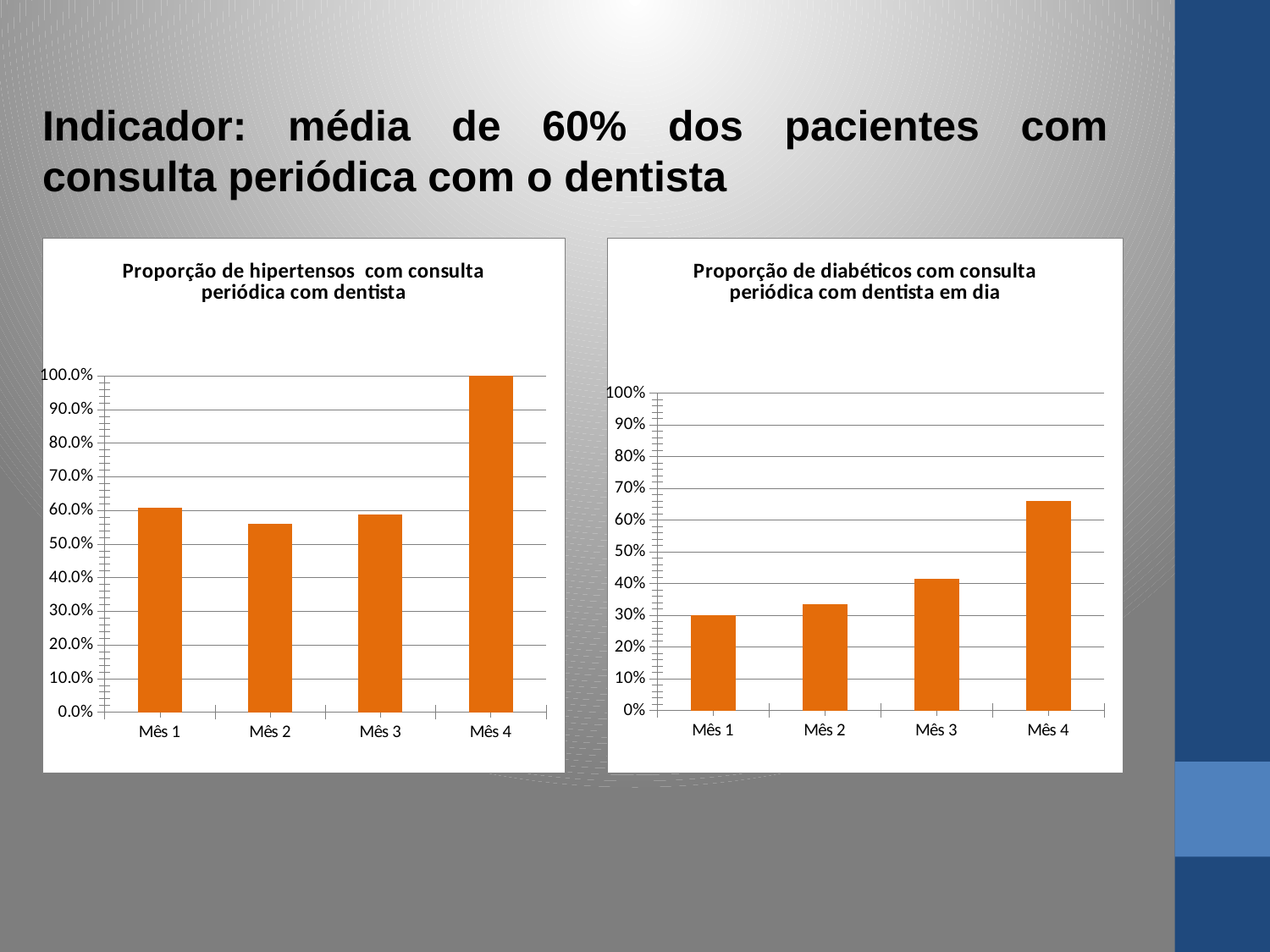
In the left chart, 'Proporção de hipertensos com consulta periódica com dentista', which month has the lowest value? Mês 2 In the right chart, 'Proporção de diabéticos com consulta periódica com dentista em dia', which is larger, the value for Mês 2 or the value for Mês 4? Mês 4 In the left chart, 'Proporção de hipertensos com consulta periódica com dentista', which month has the highest value? Mês 4 What kind of chart is the left chart, 'Proporção de hipertensos com consulta periódica com dentista'? bar chart In the right chart, 'Proporção de diabéticos com consulta periódica com dentista em dia', do the values rise or fall from Mês 1 to Mês 4? rise In the left chart, 'Proporção de hipertensos com consulta periódica com dentista', what is the value for Mês 4? 100.0% In the right chart, 'Proporção de diabéticos com consulta periódica com dentista em dia', is the value for Mês 3 greater or less than 50%? less What is the title of the right chart? Proporção de diabéticos com consulta periódica com dentista em dia In the right chart, 'Proporção de diabéticos com consulta periódica com dentista em dia', which month has the lowest value? Mês 1 In the left chart, 'Proporção de hipertensos com consulta periódica com dentista', is the value for Mês 1 greater or less than 50.0%? greater In the right chart, 'Proporção de diabéticos com consulta periódica com dentista em dia', which month has the highest value? Mês 4 How many months are shown on the x axis of the right chart, 'Proporção de diabéticos com consulta periódica com dentista em dia'? 4